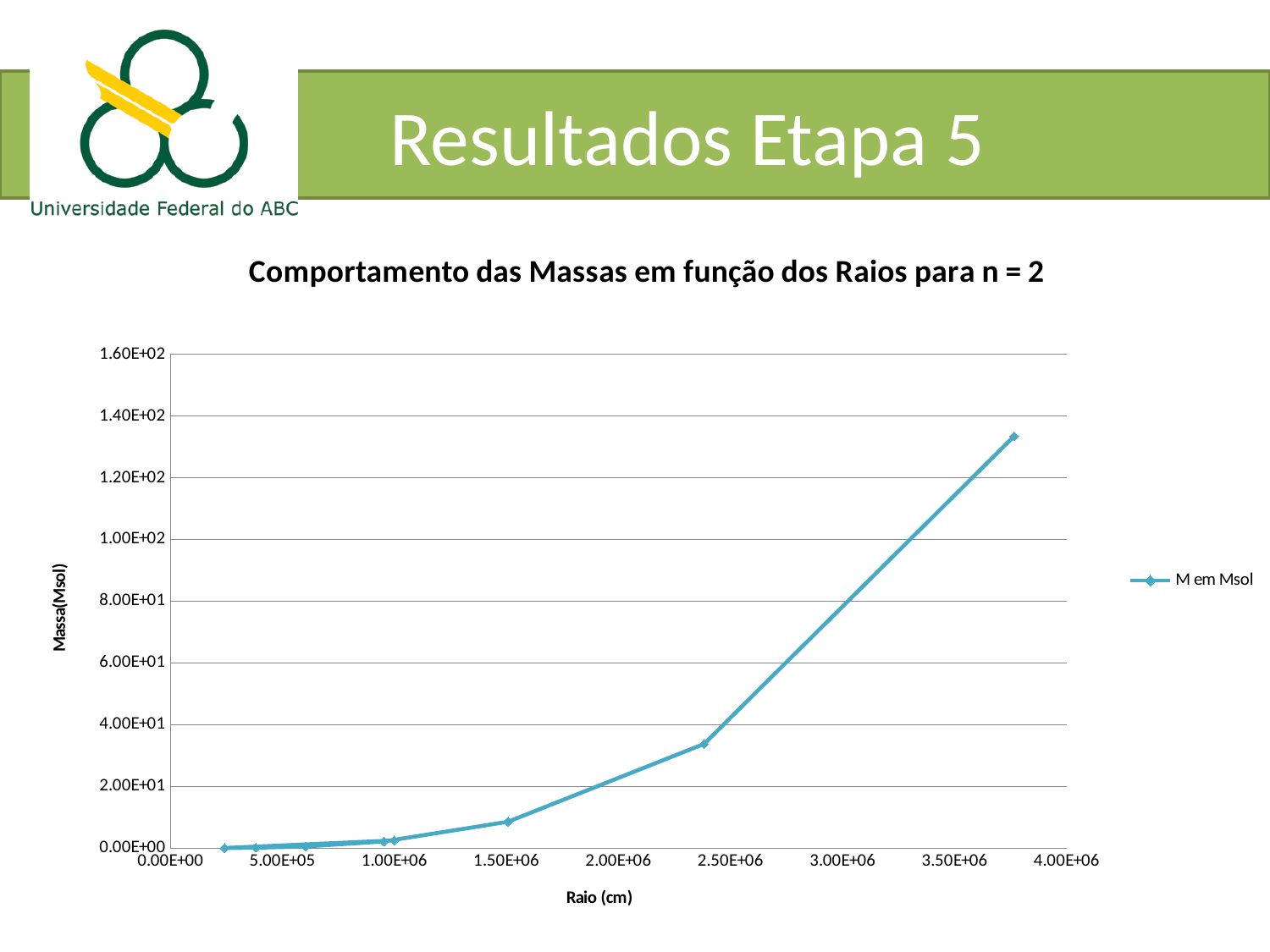
What is the title of the chart? Comportamento das Massas em função dos Raios para n = 2 Is the value of the highest point on the line greater or less than 1.20E+02? greater Is the value of the point near Raio 2.50E+06 greater or less than 4.00E+01? less Do the values of M em Msol rise or fall as Raio (cm) increases along the x axis? rise What kind of chart is shown on the slide? line chart Is the value of the point near Raio 1.50E+06 greater or less than 2.00E+01? less What is the label of the y axis? Massa(Msol) How many series does the legend list? 1 Which is larger, the mass at the point near Raio 1.50E+06 or the mass at the point near Raio 2.50E+06? the point near Raio 2.50E+06 What is the name of the series shown in the legend? M em Msol